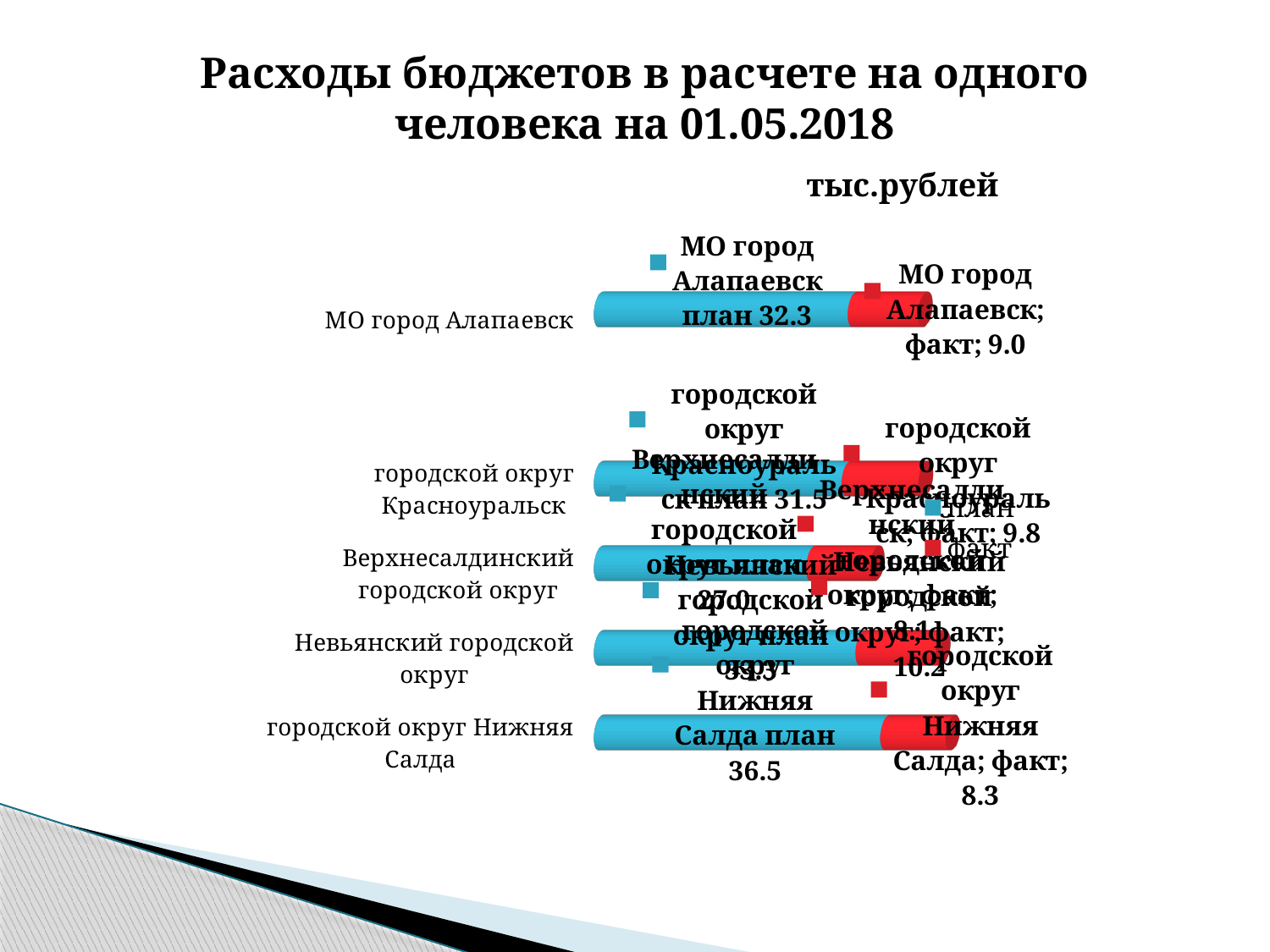
Which has the larger план value: городской округ Нижняя Салда or МО город Алапаевск? городской округ Нижняя Салда What is the факт value for городской округ Нижняя Салда? 8.3 In what units are the values on the chart expressed, according to the slide? тыс.рублей What kind of chart is shown on the slide? bar chart What is the факт (actual) value for МО город Алапаевск? 9.0 How many categories (municipalities) are plotted in the chart? 5 What is the total of the stacked bar (план plus факт) for городской округ Нижняя Салда? 44.8 What is the difference between the план and факт values for МО город Алапаевск? 23.3 How many series does the chart's legend list? 2 What is the факт value for городской округ Красноуральск? 9.8 What is the план value for городской округ Нижняя Салда? 36.5 What is the план (plan) value for МО город Алапаевск? 32.3